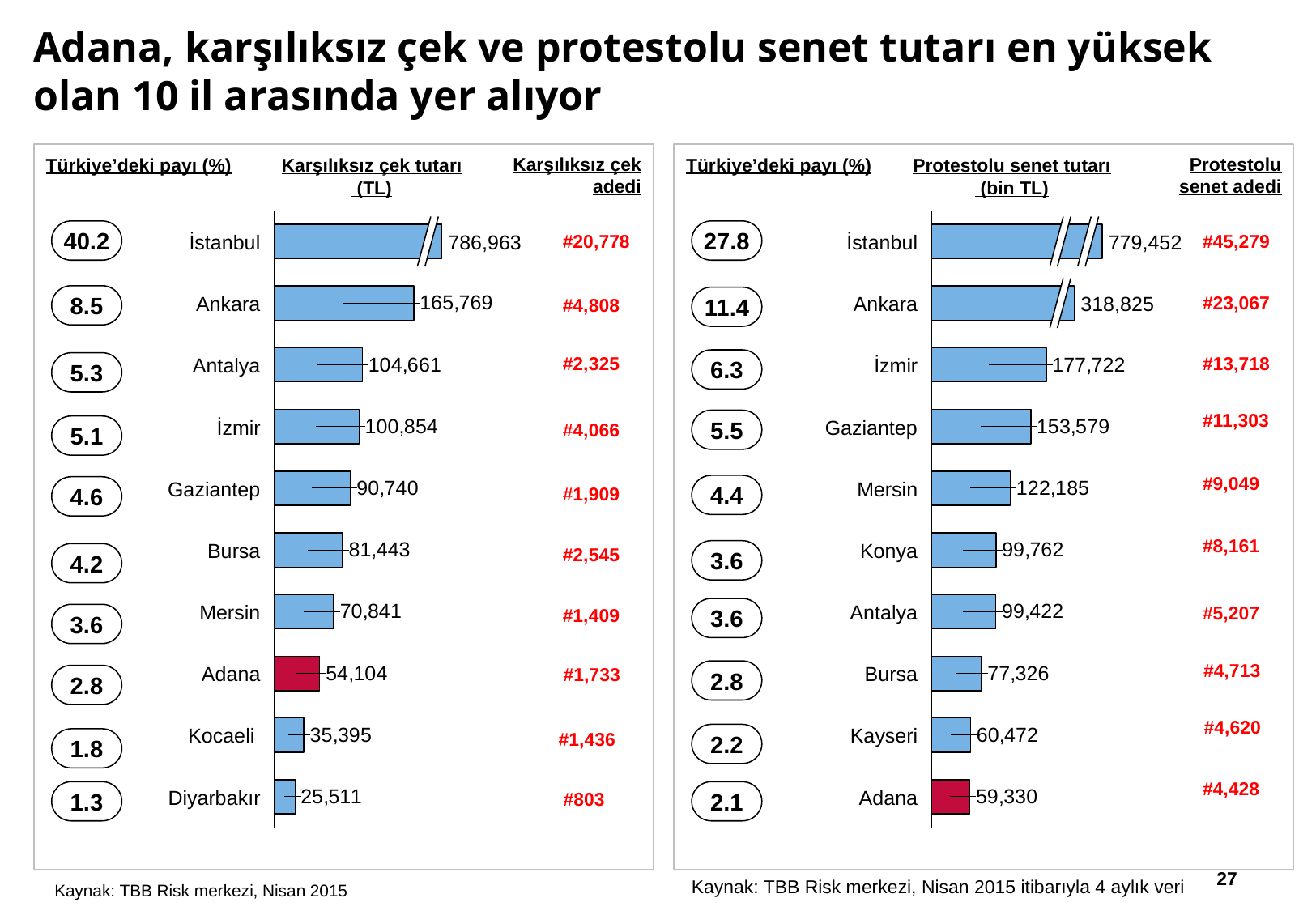
In the right chart (Protestolu senet tutarı), what is the difference between the values for Konya and Antalya? 340 What kind of chart is the left chart (Karşılıksız çek tutarı)? Bar chart In the left chart (Karşılıksız çek tutarı), what is the value for Kocaeli? 35,395 In the left chart (Karşılıksız çek tutarı), what is the difference between the values for Ankara and Antalya? 61,108 In the right chart (Protestolu senet tutarı), which is larger, the value for Mersin or the value for Bursa? Mersin In the right chart (Protestolu senet tutarı), which city has the lowest value? Adana In the right chart (Protestolu senet tutarı), what is the value for Gaziantep? 153,579 In the left chart (Karşılıksız çek tutarı), what is the value for Adana? 54,104 In the left chart, which city's bar is coloured red instead of blue? Adana How many cities are shown in the right chart (Protestolu senet tutarı)? 10 In the left chart (Karşılıksız çek tutarı), which city has the highest value? İstanbul In the left chart (Karşılıksız çek tutarı), which city has the lowest value? Diyarbakır